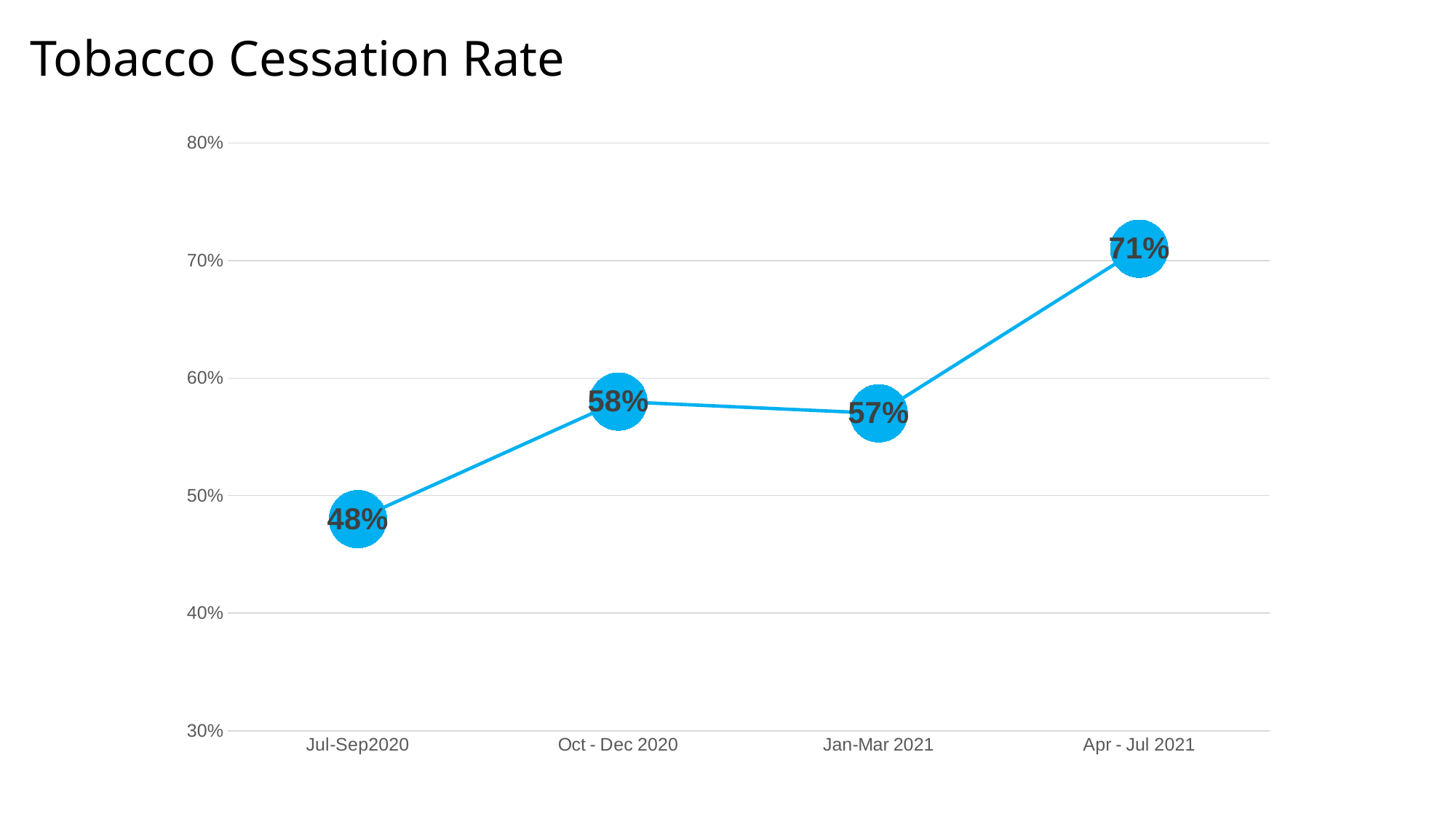
Is the value for Jul-Sep2020 greater or less than 50%? less Which period has the lowest tobacco cessation rate? Jul-Sep2020 What is the tobacco cessation rate for Apr - Jul 2021? 71% Which period has the highest tobacco cessation rate? Apr - Jul 2021 What kind of chart is shown on the slide? line chart What is the tobacco cessation rate for Jan-Mar 2021? 57% What is the title of the chart? Tobacco Cessation Rate What is the tobacco cessation rate for Oct - Dec 2020? 58% What is the difference between the cessation rate for Apr - Jul 2021 and Jul-Sep2020? 23% How many periods are plotted on the chart? 4 What is the tobacco cessation rate for Jul-Sep2020? 48% Which is larger, the cessation rate for Oct - Dec 2020 or Apr - Jul 2021? Apr - Jul 2021